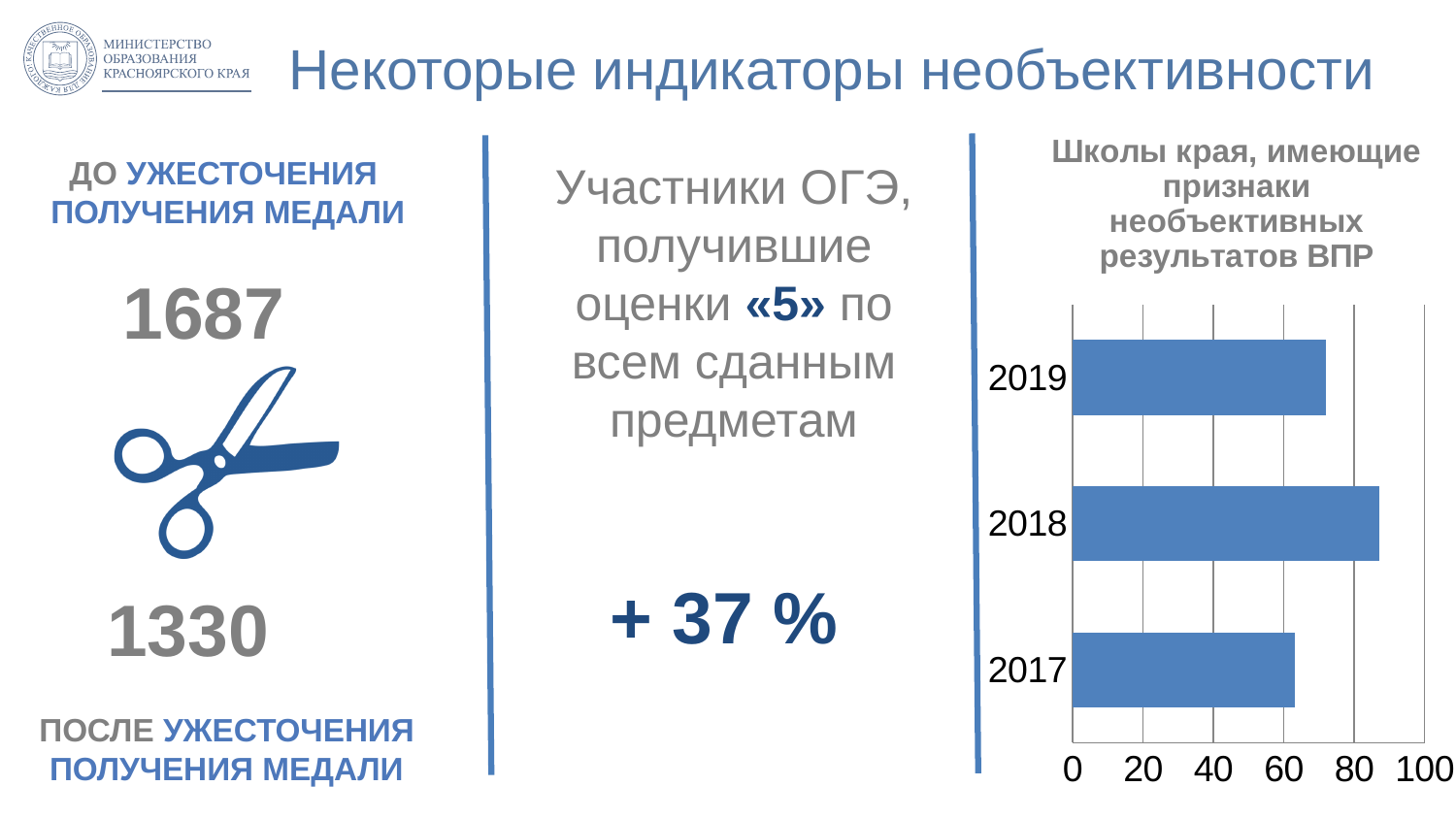
How many years (categories) are shown in the bar chart? 3 Which year has the highest value in the bar chart? 2018 Is the value for 2018 in the bar chart greater or less than 80? greater In the bar chart, which year has the larger value, 2019 or 2017? 2019 Is the value for 2019 in the bar chart greater or less than 60? greater What kind of chart is shown on the right side of the slide? bar chart What is the maximum value shown on the horizontal axis of the bar chart? 100 What is the title of the chart on the right side of the slide? Школы края, имеющие признаки необъективных результатов ВПР Which year has the lowest value in the bar chart? 2017 Is the value for 2019 in the bar chart greater or less than 80? less In the bar chart, which year has the larger value, 2018 or 2019? 2018